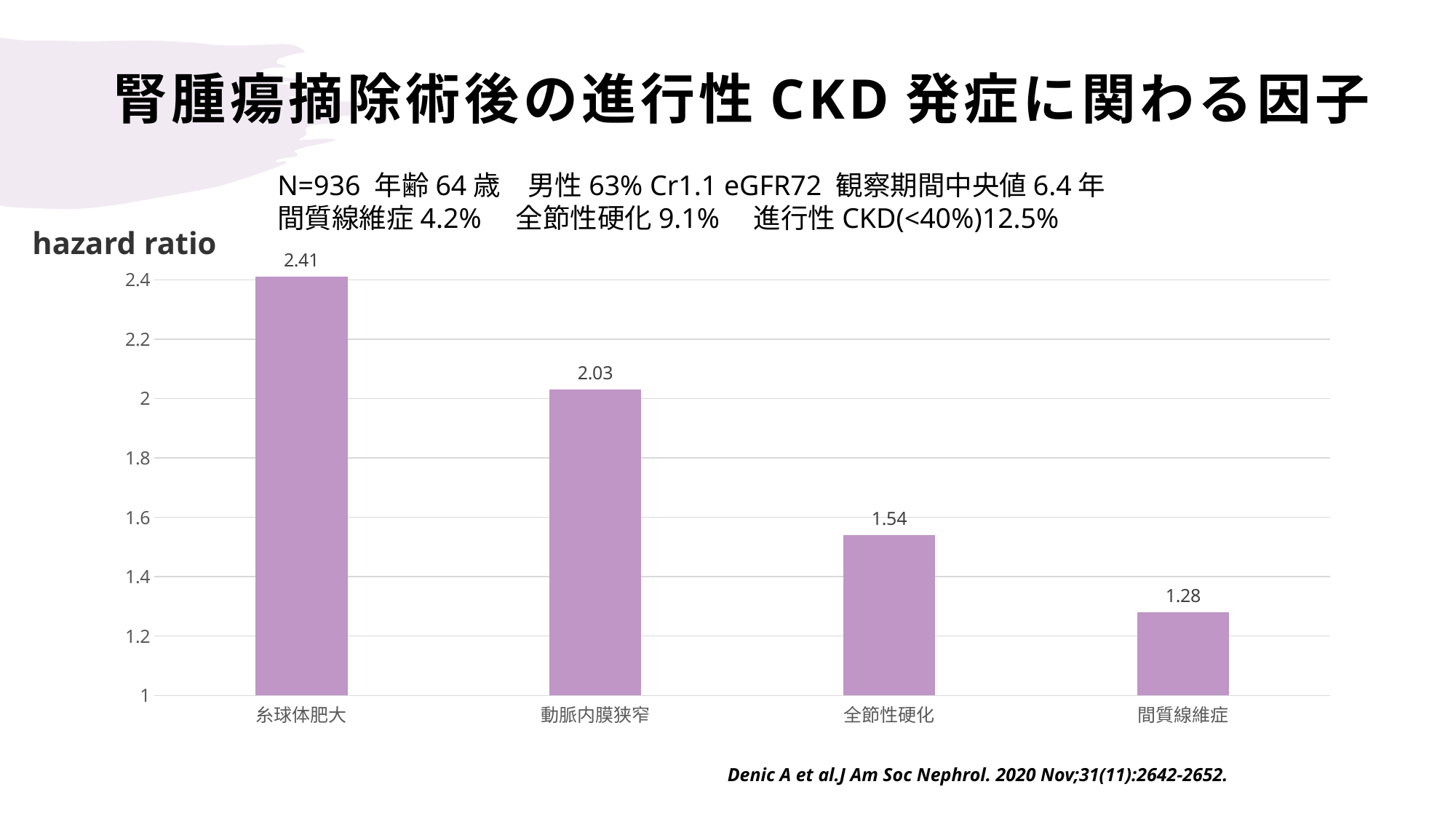
What is the hazard ratio for 糸球体肥大? 2.41 What is the hazard ratio for 全節性硬化? 1.54 Which has a larger hazard ratio, 動脈内膜狭窄 or 全節性硬化? 動脈内膜狭窄 Do the hazard ratios rise or fall from left to right across the chart? fall What kind of chart is shown on the slide? bar chart What is the difference between the hazard ratios for 動脈内膜狭窄 and 全節性硬化? 0.49 Which factor has the highest hazard ratio? 糸球体肥大 What is the difference between the hazard ratios for 糸球体肥大 and 間質線維症? 1.13 What is the hazard ratio for 動脈内膜狭窄? 2.03 How many factors are shown in the chart? 4 What is the hazard ratio for 間質線維症? 1.28 Which factor has the lowest hazard ratio? 間質線維症